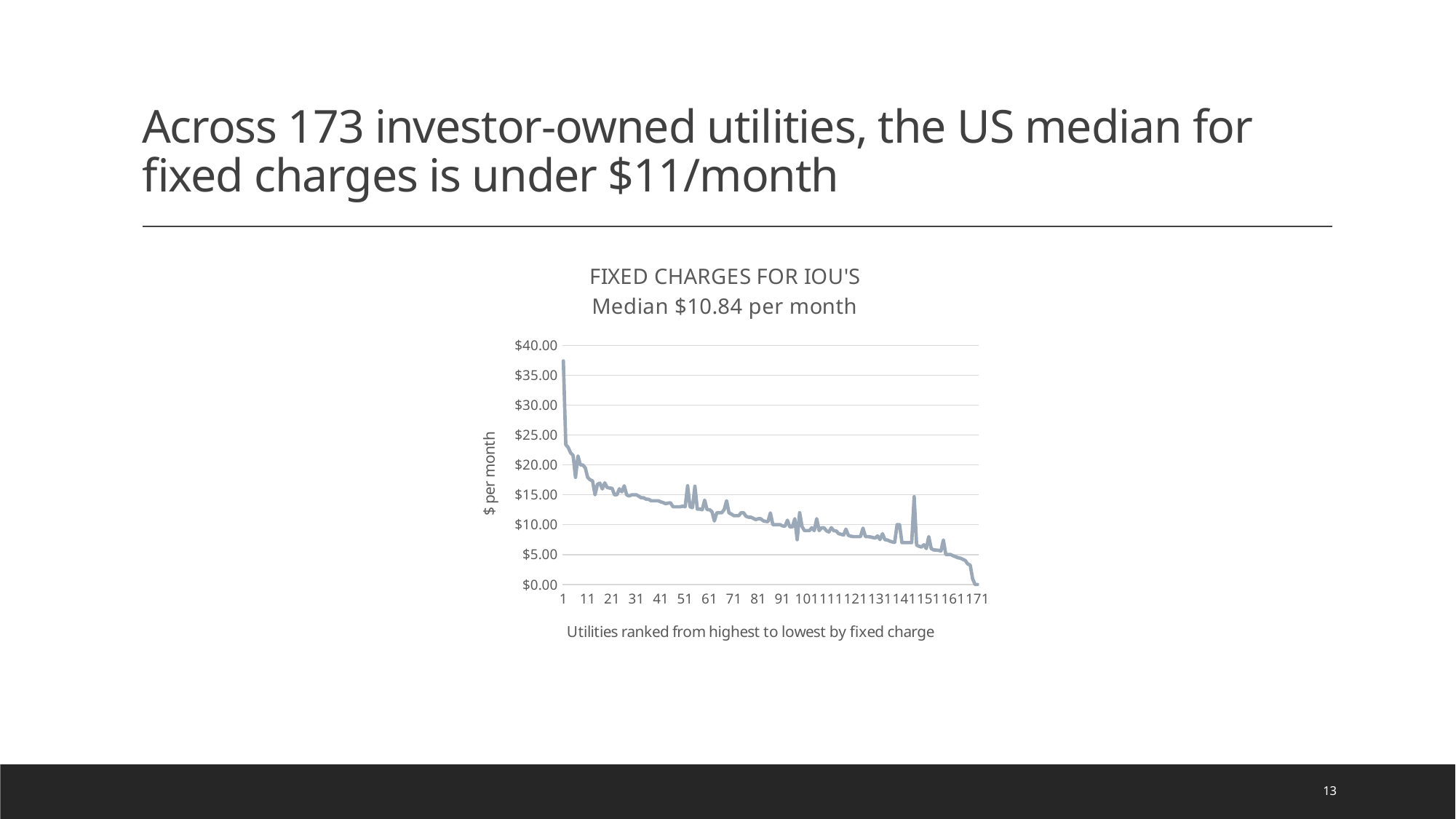
What kind of chart is shown on the slide? line chart Which utility rank has the highest fixed charge? 1 Is the value for the utility ranked 11 greater or less than $20.00? less Do the values rise or fall as the utility rank increases along the x axis? fall Is the value for the utility ranked 141 greater or less than $20.00? less What is the median fixed charge per month stated in the chart title? $10.84 per month What is the highest value shown on the y axis? $40.00 Is the value for the utility ranked 171 greater or less than $5.00? less What is the label of the y axis? $ per month